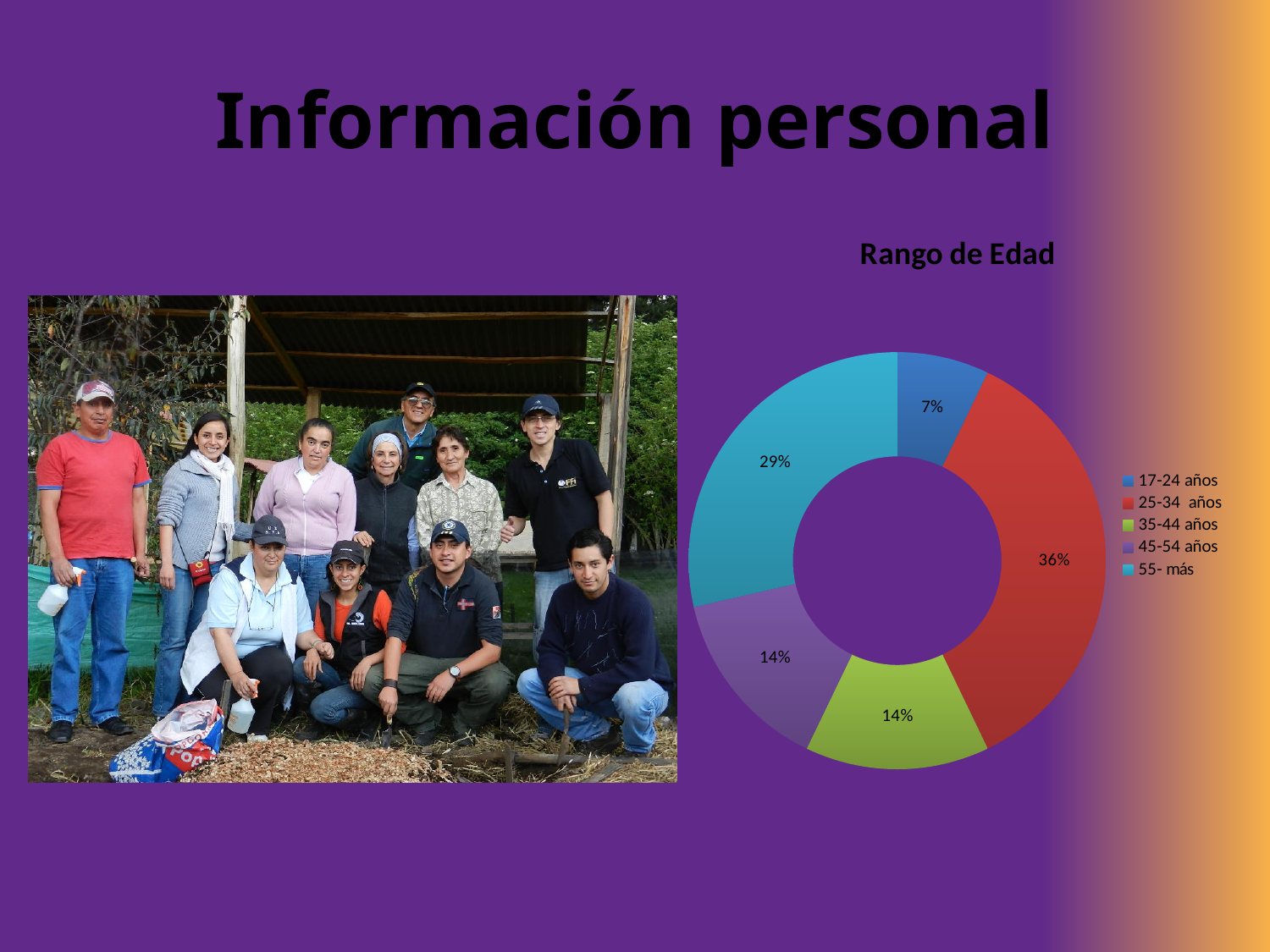
What percentage is shown for the 55- más category? 29% What is the difference in percentage points between the 25-34 años and 55- más categories? 7 What percentage is shown for the 35-44 años category? 14% What kind of chart is shown on the slide? doughnut chart How many age range categories does the legend list? 5 What percentage is shown for the 17-24 años category? 7% Which age range has the largest share? 25-34 años What is the title of the chart? Rango de Edad Which age range has the smallest share? 17-24 años What colour represents the 25-34 años category? red Which is larger, the share for 55- más or the share for 45-54 años? 55- más What percentage is shown for the 25-34 años category? 36%